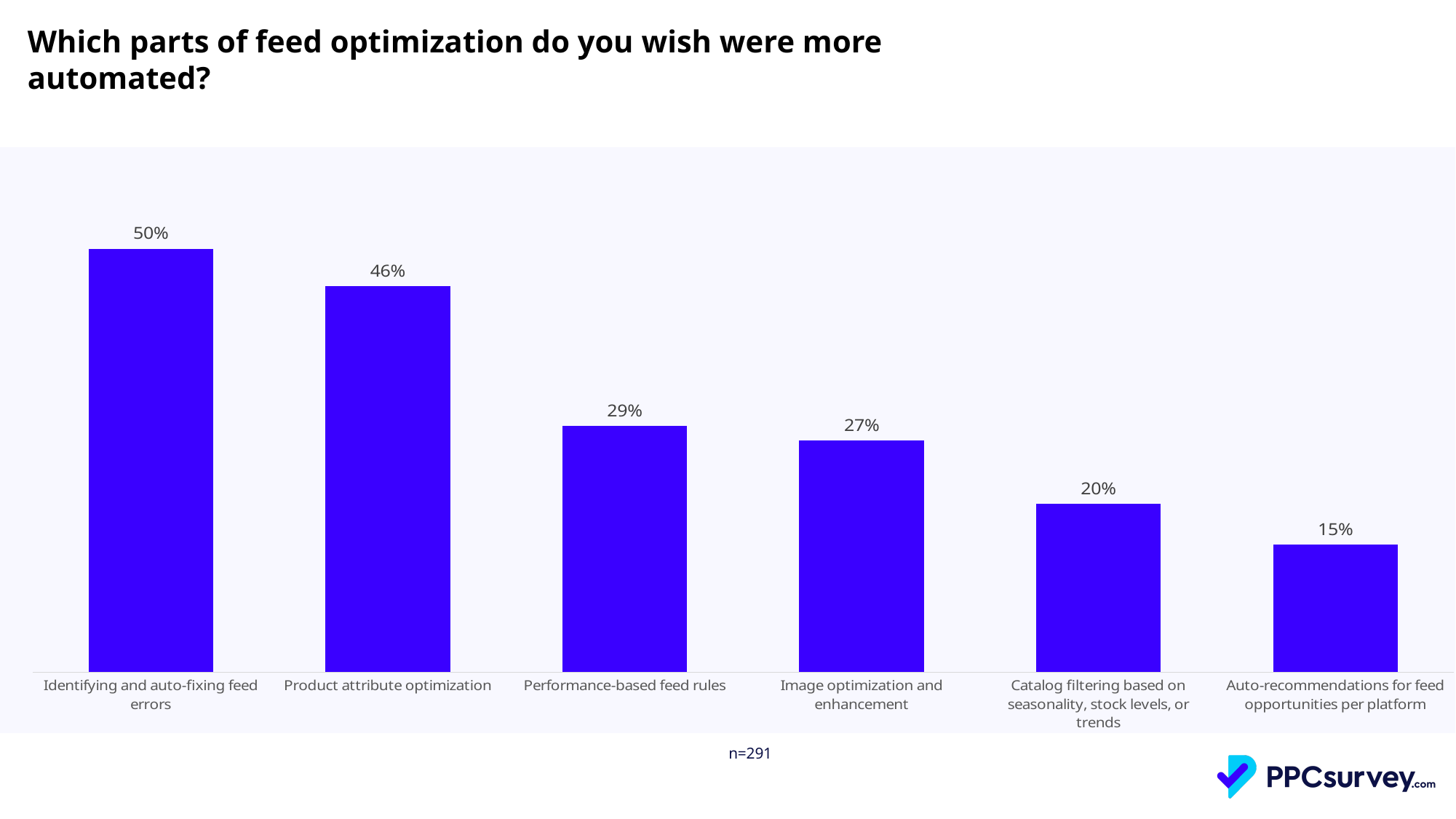
What is the value for 'Image optimization and enhancement'? 27% Which category has the highest value? Identifying and auto-fixing feed errors How many categories are shown in the chart? 6 Do the values rise or fall from left to right across the categories? Fall Which category has the lowest value? Auto-recommendations for feed opportunities per platform What kind of chart is shown on the slide? Bar chart What is the value for 'Auto-recommendations for feed opportunities per platform'? 15% What is the value for 'Product attribute optimization'? 46% What percentage of respondents wish 'Identifying and auto-fixing feed errors' were more automated? 50% Which is larger: 'Product attribute optimization' or 'Performance-based feed rules'? Product attribute optimization What is the difference between 'Performance-based feed rules' and 'Catalog filtering based on seasonality, stock levels, or trends'? 9% What is the sample size (n) noted below the chart? n=291